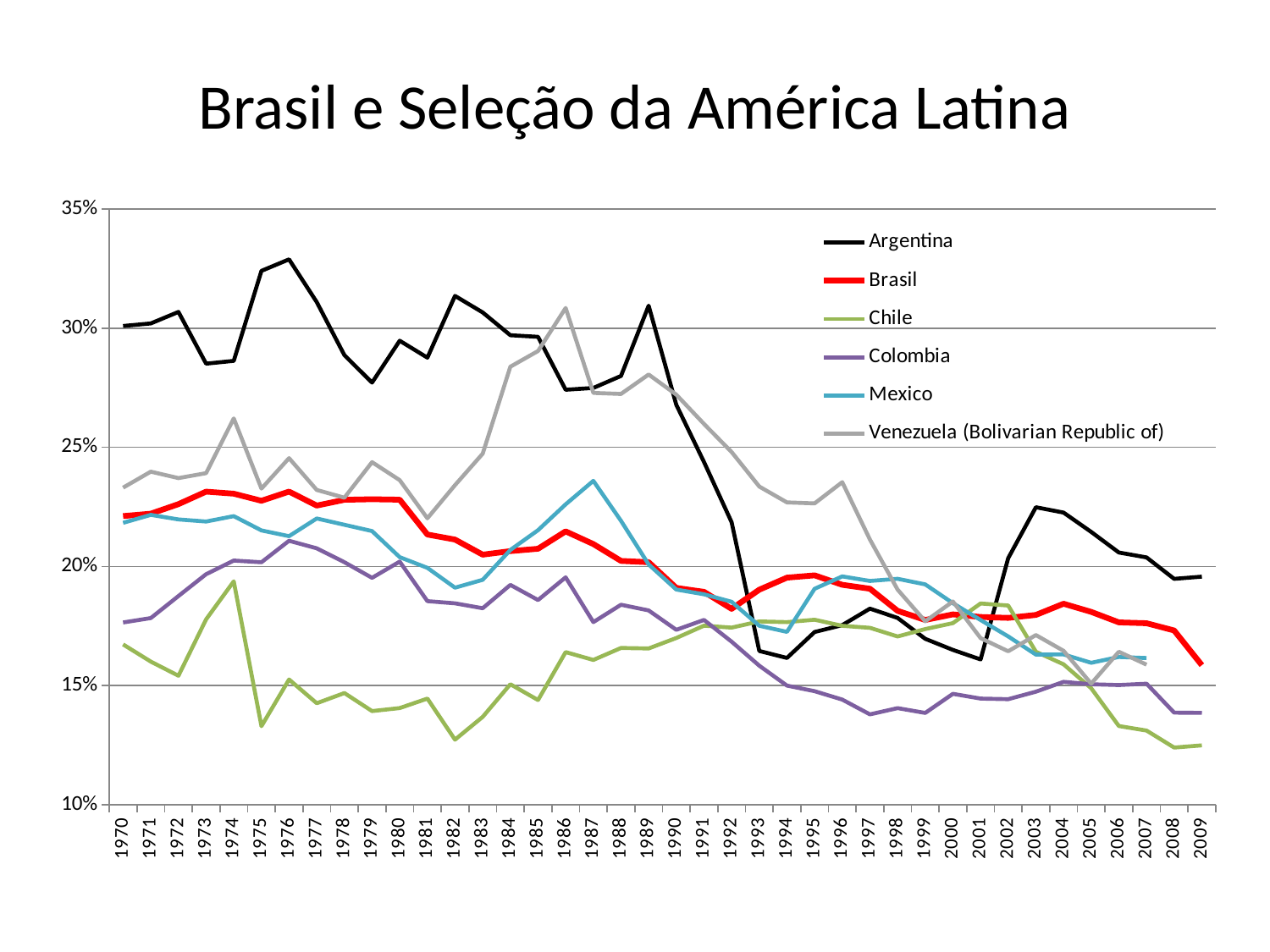
How many years are plotted along the x axis? 40 How many series does the legend list? 6 What is the title of the chart? Brasil e Seleção da América Latina What colour is the Brasil line? red What kind of chart is shown on the slide? line chart Does the Argentina line rise or fall between 1989 and 1993? fall In 1986, which is higher: Venezuela (Bolivarian Republic of) or Argentina? Venezuela (Bolivarian Republic of) Which series has the lowest value in 2009? Chile Is the value for Mexico in 1987 greater or less than 20%? greater Which series has the highest value in 1970? Argentina Is the value for Chile in 1975 greater or less than 15%? less Is the value for Argentina in 1976 greater or less than 30%? greater